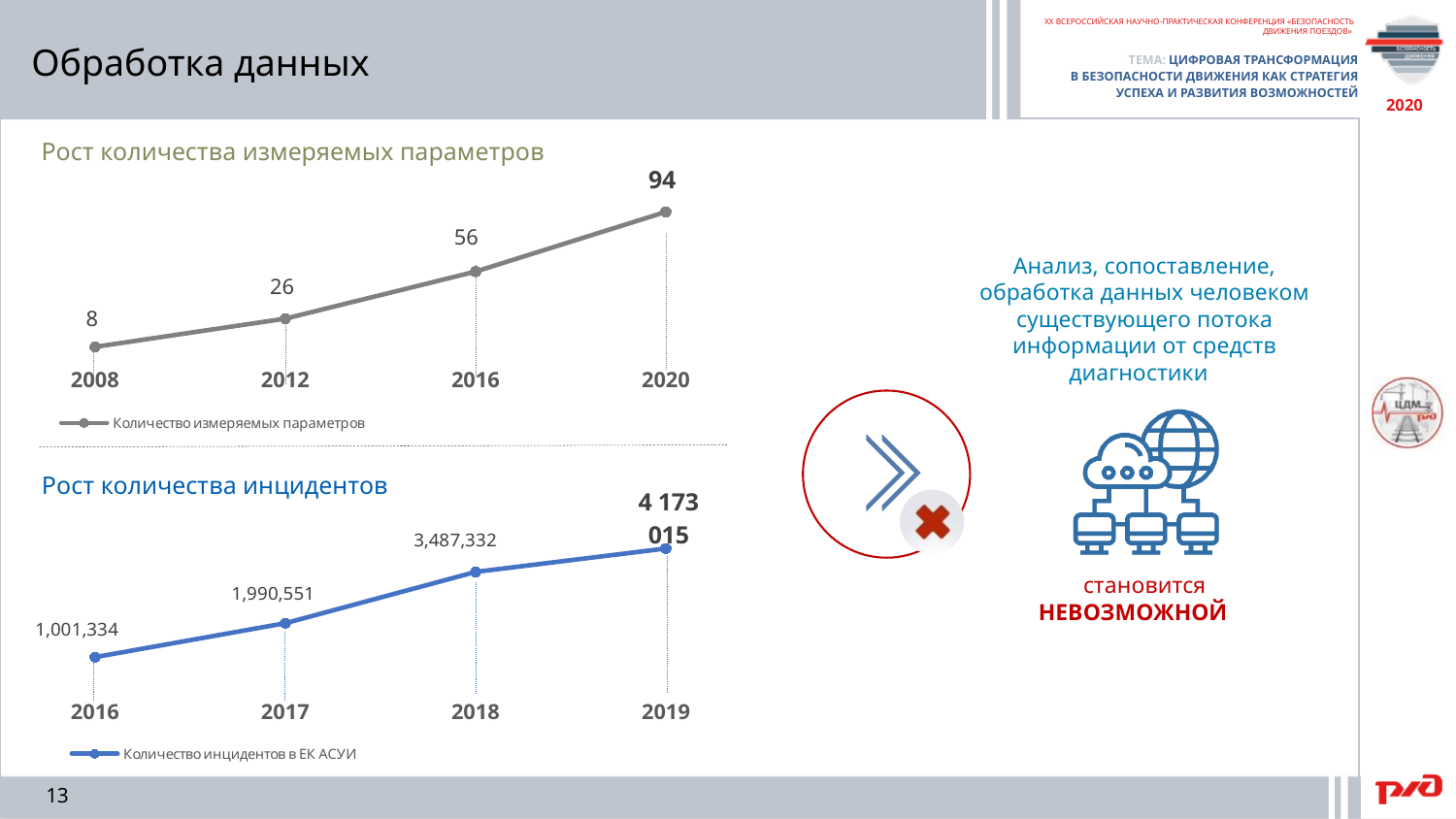
In the chart 'Рост количества инцидентов', which year has the lowest value? 2016 In the chart 'Рост количества измеряемых параметров', what is the difference between the values for 2020 and 2012? 68 In the chart 'Рост количества измеряемых параметров', which year has the highest value? 2020 What is the legend entry of the chart 'Рост количества инцидентов'? Количество инцидентов в ЕК АСУИ In the chart 'Рост количества измеряемых параметров', do the values rise or fall from 2008 to 2020? rise In the chart 'Рост количества измеряемых параметров', how many data points are plotted? 4 In the chart 'Рост количества инцидентов', what is the value for 2017? 1,990,551 In the chart 'Рост количества инцидентов', what is the value for 2019? 4 173 015 In the chart 'Рост количества измеряемых параметров', what is the value for 2016? 56 What type of chart is 'Рост количества инцидентов'? line chart In the chart 'Рост количества инцидентов', which is larger, the value for 2018 or the value for 2017? 2018 In the chart 'Рост количества измеряемых параметров', what is the value for 2008? 8